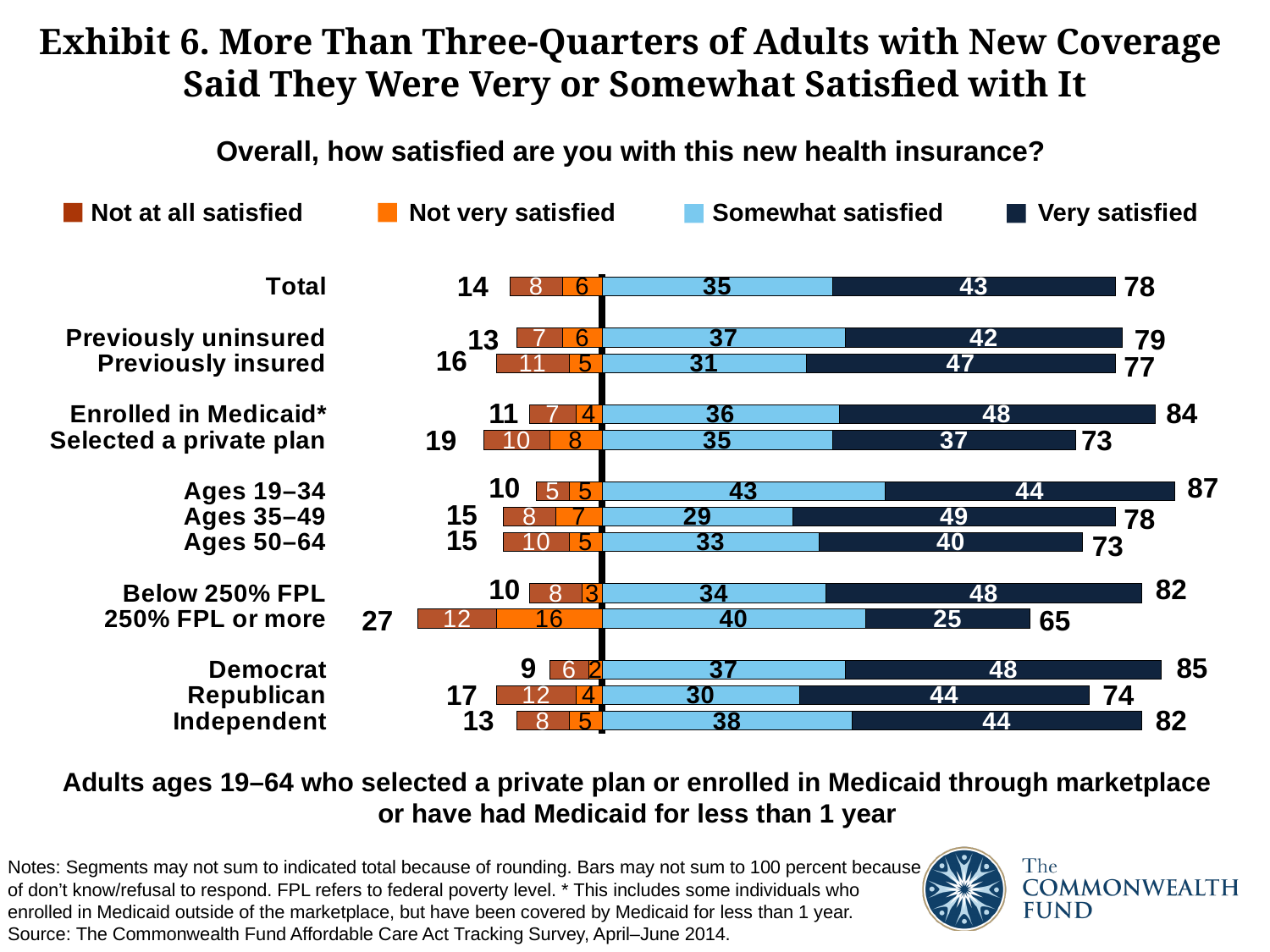
Which legend entry is shown in the darkest colour? Very satisfied Which group has a larger very satisfied value, Democrat or Republican? Democrat What is the difference between the very satisfied values for Enrolled in Medicaid* and Selected a private plan? 11 Which group has the highest combined very or somewhat satisfied total? Ages 19–34 Which group has the lowest combined very or somewhat satisfied total? 250% FPL or more How many series does the legend list? 4 What percentage of Republicans said they were somewhat satisfied? 30 What is the combined very or somewhat satisfied total shown for the Total group? 78 What percentage of adults ages 19–34 said they were very satisfied with their new coverage? 44 How many groups (bars) are shown in the chart? 13 What kind of chart is shown on the slide? Stacked bar chart What is the combined not at all or not very satisfied total shown for the 250% FPL or more group? 27